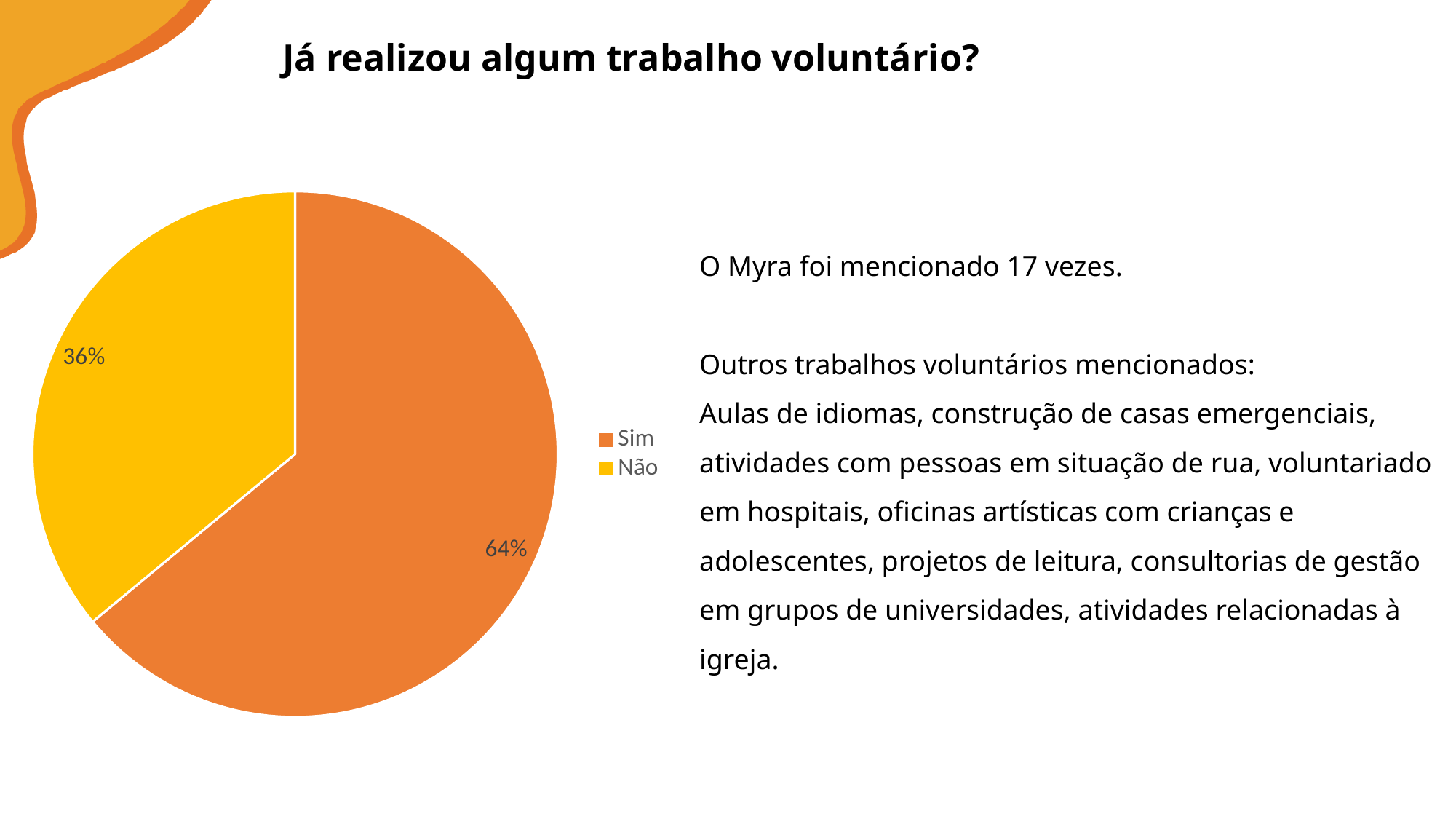
What percentage of respondents answered "Não"? 36% What kind of chart is shown on the slide? Pie chart What share of the pie does the "Não" slice represent? 36% What percentage of respondents answered "Sim"? 64% Which category has the smallest share of the pie? Não Which is larger, the share for "Sim" or the share for "Não"? Sim What colour is the "Não" slice? Yellow How many slices does the pie chart have? 2 Which category has the largest share of the pie? Sim What is the difference in percentage points between "Sim" and "Não"? 28 What colour is the "Sim" slice? Orange How many entries does the legend list? 2